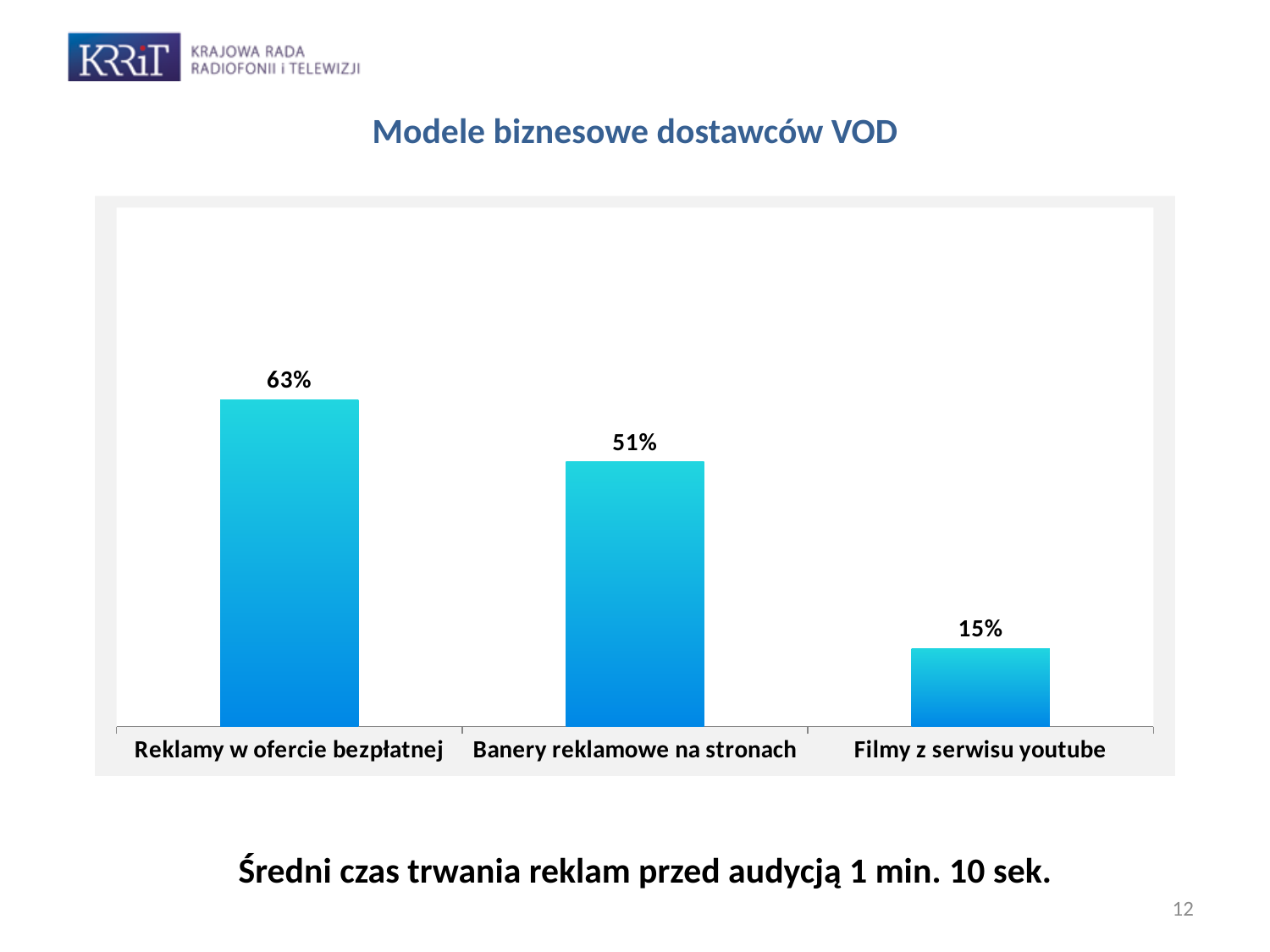
What is the value for Reklamy w ofercie bezpłatnej? 63% What is the value for Banery reklamowe na stronach? 51% Which is larger, the value for Banery reklamowe na stronach or the value for Filmy z serwisu youtube? Banery reklamowe na stronach What is the difference between the values for Reklamy w ofercie bezpłatnej and Banery reklamowe na stronach? 12% What is the value for Filmy z serwisu youtube? 15% What is the difference between the values for Banery reklamowe na stronach and Filmy z serwisu youtube? 36% Which category has the highest value? Reklamy w ofercie bezpłatnej Which category has the lowest value? Filmy z serwisu youtube What is the title of the slide above the chart? Modele biznesowe dostawców VOD How many categories are shown in the chart? 3 What kind of chart is shown on the slide? bar chart Do the values rise or fall from left to right across the categories? fall